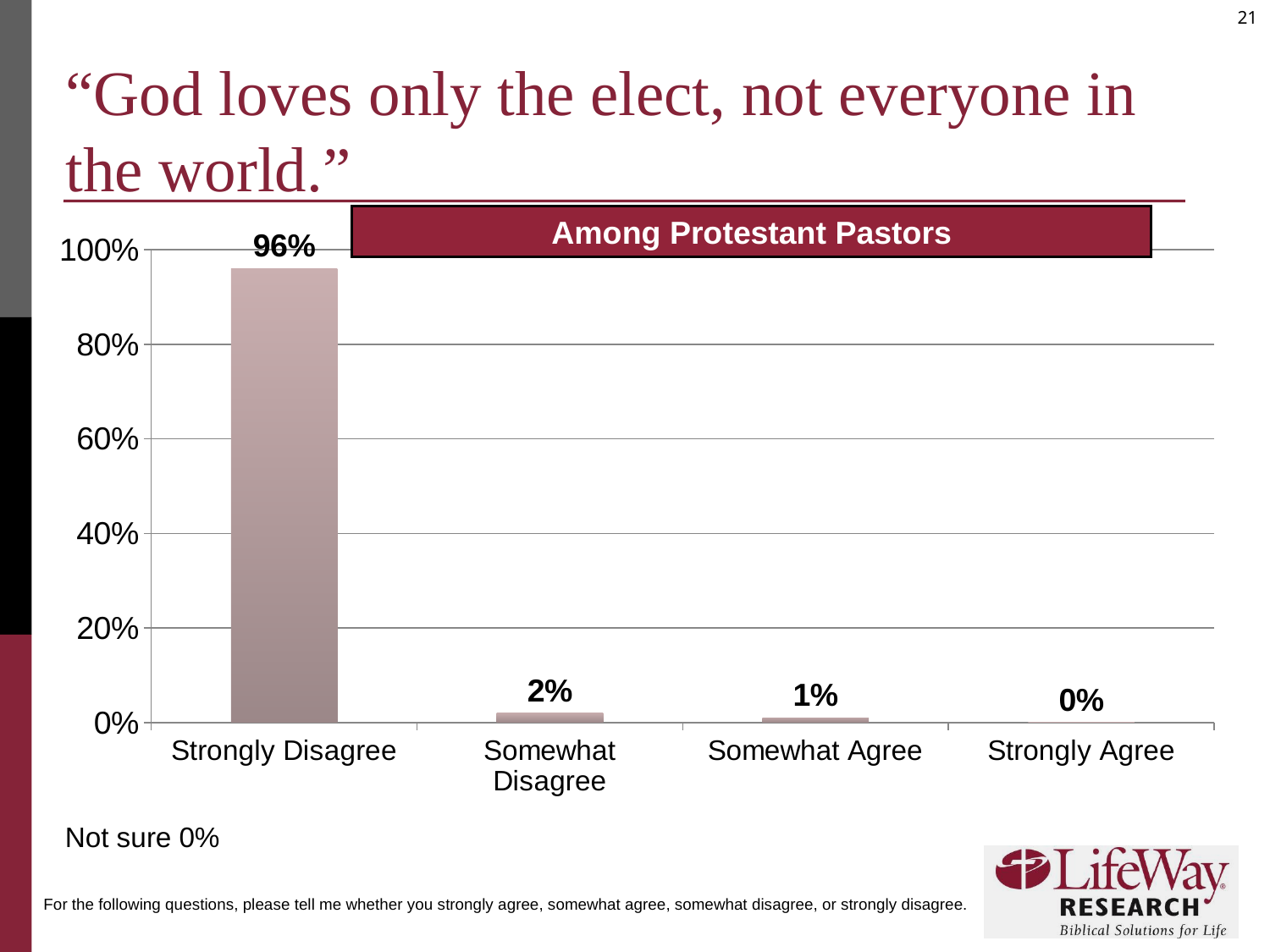
Is the value for Strongly Disagree greater or less than 80%? greater What is the difference between the Strongly Disagree and Somewhat Disagree values? 94% What percentage of Protestant pastors strongly disagree with the statement? 96% How many response categories are shown on the x axis of the chart? 4 Which response category has the highest value? Strongly Disagree What kind of chart is shown on the slide? Bar chart What is the value for Strongly Agree? 0% What is the value for Somewhat Disagree? 2% Which is larger, the value for Somewhat Disagree or the value for Somewhat Agree? Somewhat Disagree What group does the chart's label say the results are among? Among Protestant Pastors Which response category has the lowest value? Strongly Agree What is the value for Somewhat Agree? 1%